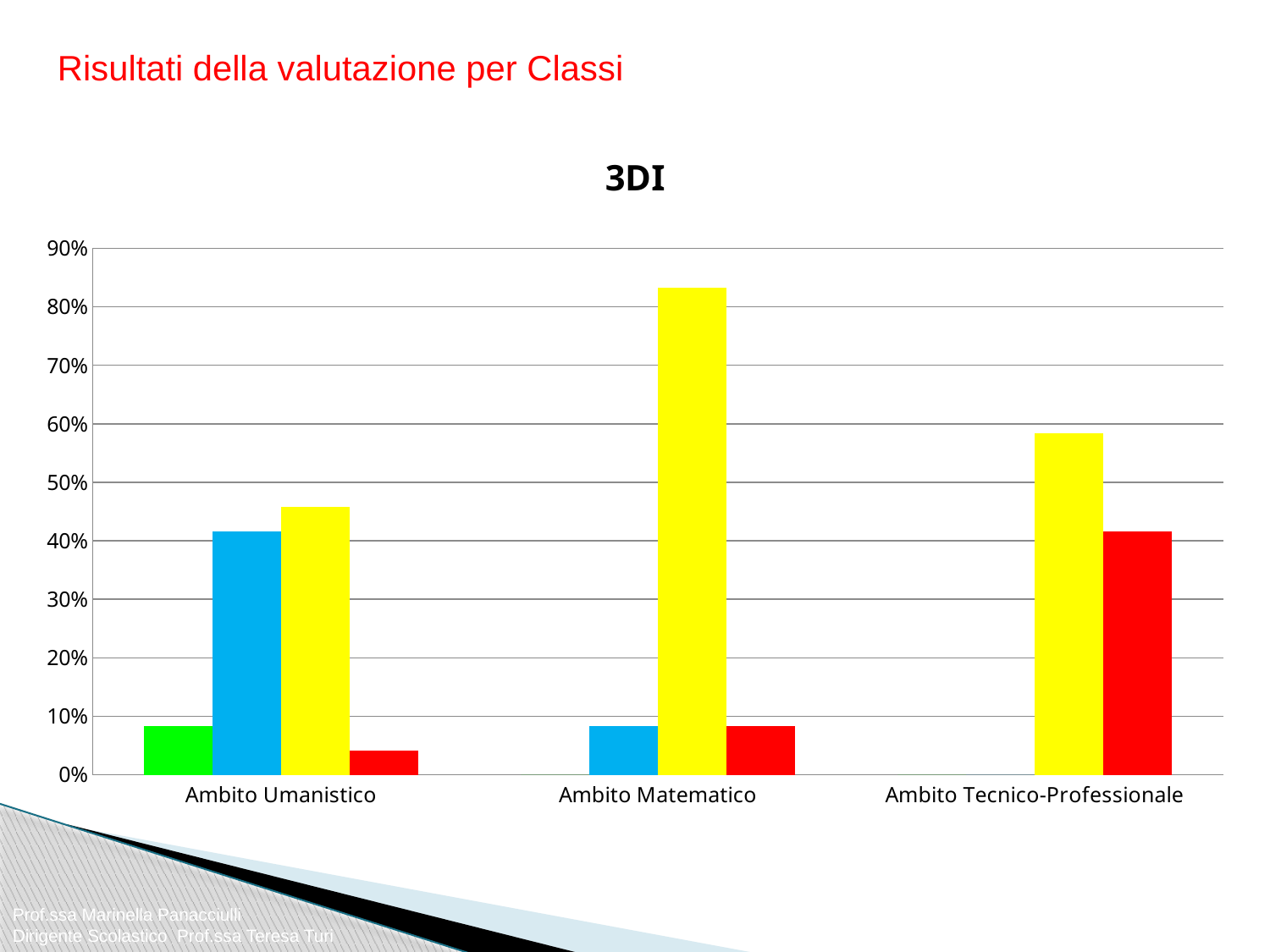
What kind of chart is shown on the slide? bar chart In Ambito Tecnico-Professionale, which bar is taller, the yellow one or the red one? yellow How many categories are shown on the x axis of the chart? 3 Is the value of the red bar for Ambito Umanistico greater or less than 10%? less Is the value of the yellow bar for Ambito Matematico greater or less than 80%? greater In which category is the yellow bar the tallest? Ambito Matematico What is the title of the chart? 3DI Is the value of the red bar for Ambito Tecnico-Professionale greater or less than 30%? greater In which category is the red bar the shortest? Ambito Umanistico In Ambito Umanistico, which bar is taller, the blue one or the green one? blue